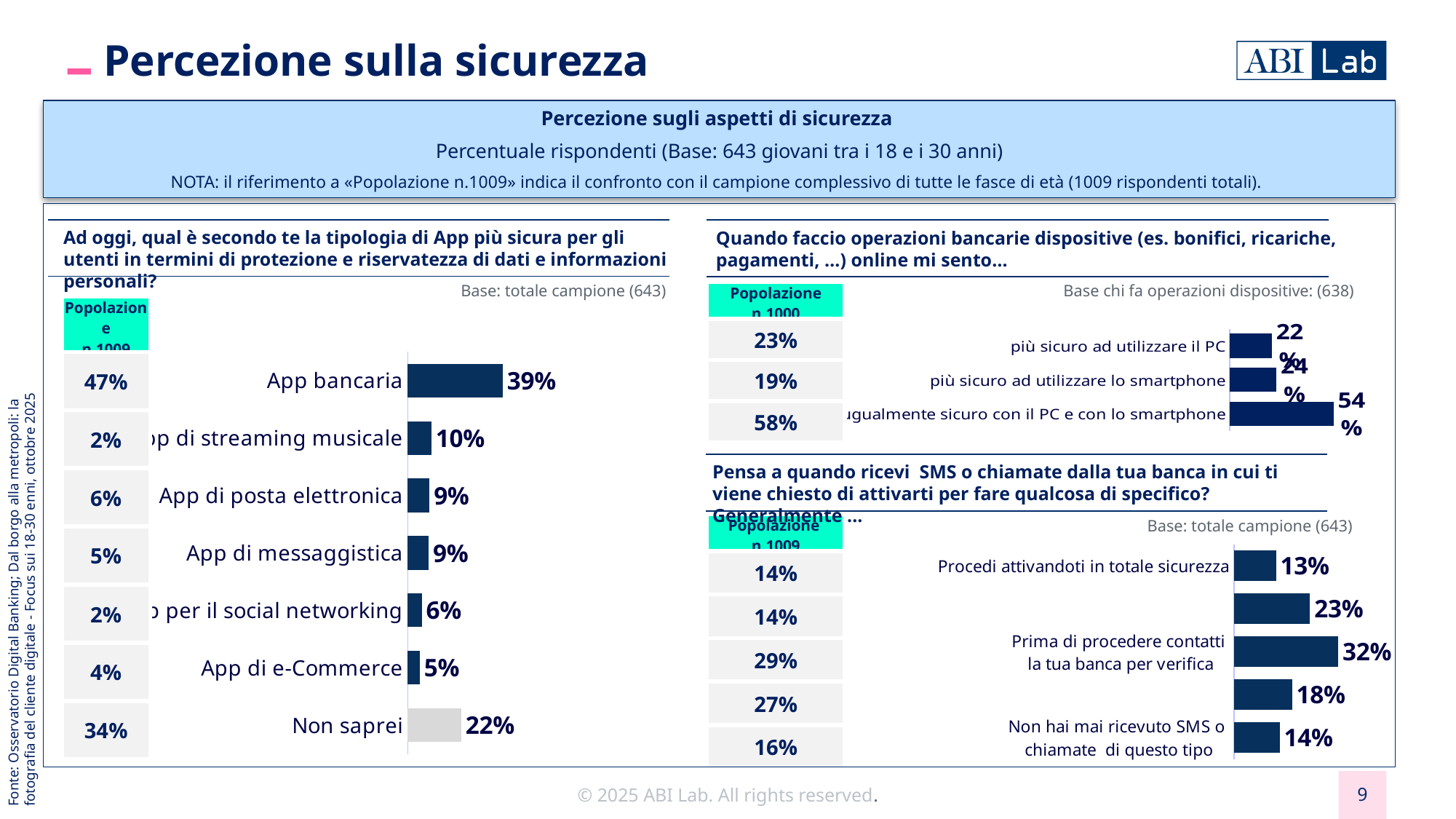
In the left chart about the safest type of App, which category has the highest value? App bancaria What type of chart is used in the left chart about the safest type of App? Bar chart In the left chart about the safest type of App, what percentage is shown for 'App bancaria'? 39% In the bottom-right chart about SMS or calls from the bank, what percentage is shown for 'Procedi attivandoti in totale sicurezza'? 13% In the left chart about the safest type of App, what is the difference between 'App bancaria' and 'Non saprei'? 17% In the bottom-right chart about SMS or calls from the bank, what percentage is shown for 'Prima di procedere contatti la tua banca per verifica'? 32% In the top-right chart about online banking operations, what percentage is shown for 'ugualmente sicuro con il PC e con lo smartphone'? 54% In the top-right chart about online banking operations, which category has the highest value? ugualmente sicuro con il PC e con lo smartphone In the left chart about the safest type of App, what percentage is shown for 'Non saprei'? 22% In the left chart about the safest type of App, which category has the lowest value? App di e-Commerce In the left chart about the safest type of App, which is larger: 'App di streaming musicale' or 'App di e-Commerce'? App di streaming musicale In the left chart about the safest type of App, how many categories are plotted? 7